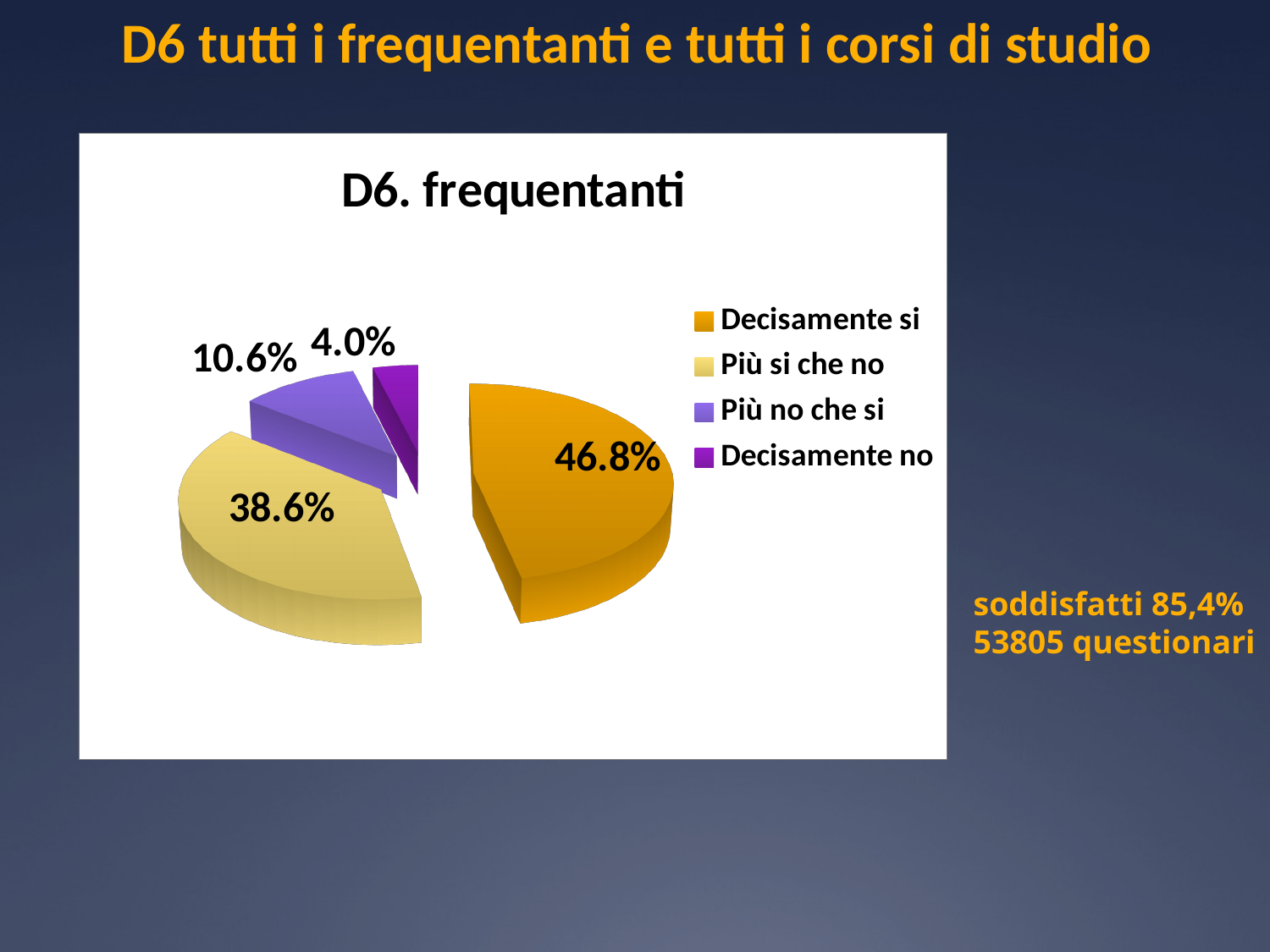
What percentage is shown for 'Più si che no'? 38.6% What percentage is shown for 'Decisamente no'? 4.0% What is the difference in percentage points between 'Decisamente si' and 'Più si che no'? 8.2 How many slices does the pie chart have? 4 What is the title of the chart? D6. frequentanti Which is larger, the 'Più no che si' slice or the 'Decisamente no' slice? Più no che si Which colour represents 'Decisamente si' in the legend? Orange What percentage is shown for 'Più no che si'? 10.6% What percentage of the pie does the 'Decisamente si' slice represent? 46.8% Which category has the smallest slice of the pie? Decisamente no What type of chart is shown on the slide? Pie chart Which category has the largest slice of the pie? Decisamente si